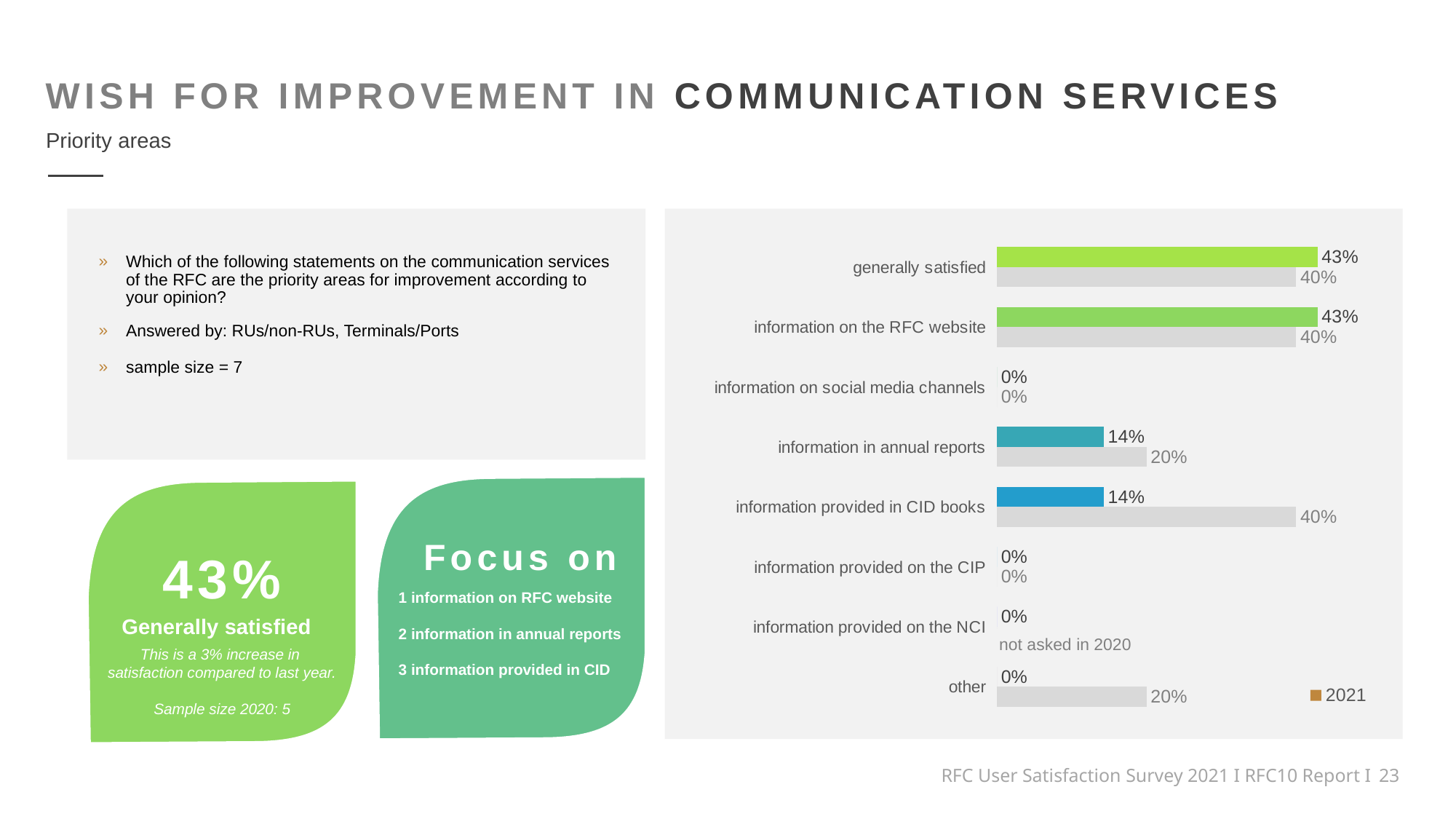
What is the 2021 value for "generally satisfied"? 43% Which series is listed in the chart legend? 2021 What is the 2020 value for "information provided in CID books"? 40% How many categories are shown in the chart? 8 What is the difference between the 2021 and 2020 values for "information on the RFC website"? 3% What is the difference between the 2020 and 2021 values for "information provided in CID books"? 26% What is the 2021 value for "information in annual reports"? 14% What is shown instead of a 2020 value for "information provided on the NCI"? not asked in 2020 What is the 2020 value for "other"? 20% Which is larger for "information in annual reports": the 2021 value or the 2020 value? 2020 What kind of chart is shown on the slide? bar chart What is the 2021 value for "information on social media channels"? 0%